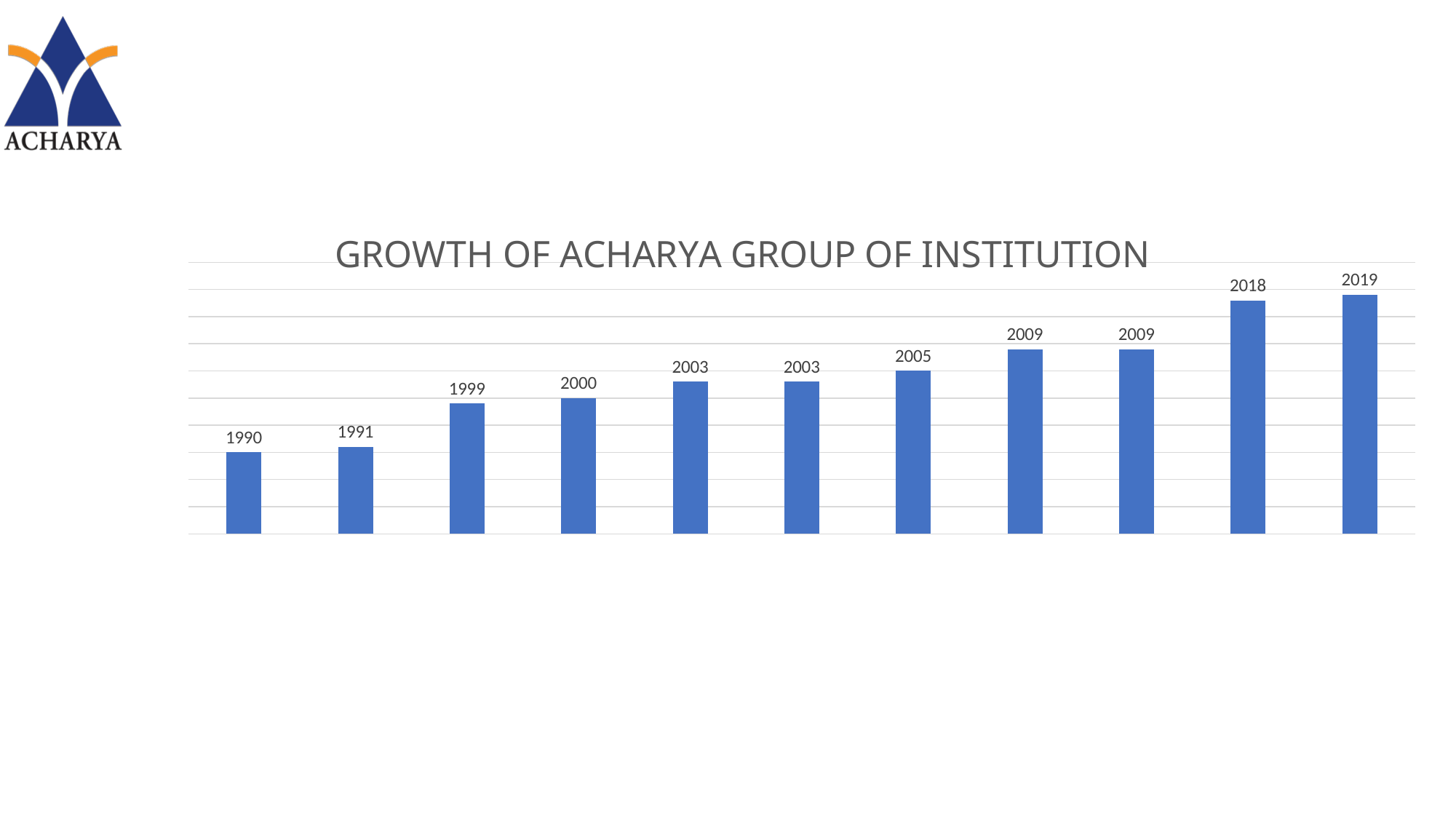
What is the data label on the leftmost bar of the chart? 1990 Which data label belongs to the shortest bar in the chart? 1990 What is the data label on the third bar from the left? 1999 What is the difference between the data label on the rightmost bar and the data label on the leftmost bar? 29 What is the title of the chart? GROWTH OF ACHARYA GROUP OF INSTITUTION Do the bar heights generally rise or fall from left to right across the chart? rise How many bars in the chart carry the data label 2009? 2 How many bars are plotted in the chart? 11 What kind of chart is shown on the slide? bar chart Which bar is taller, the leftmost bar or the rightmost bar? the rightmost bar What is the data label on the rightmost bar of the chart? 2019 Which data label belongs to the tallest bar in the chart? 2019